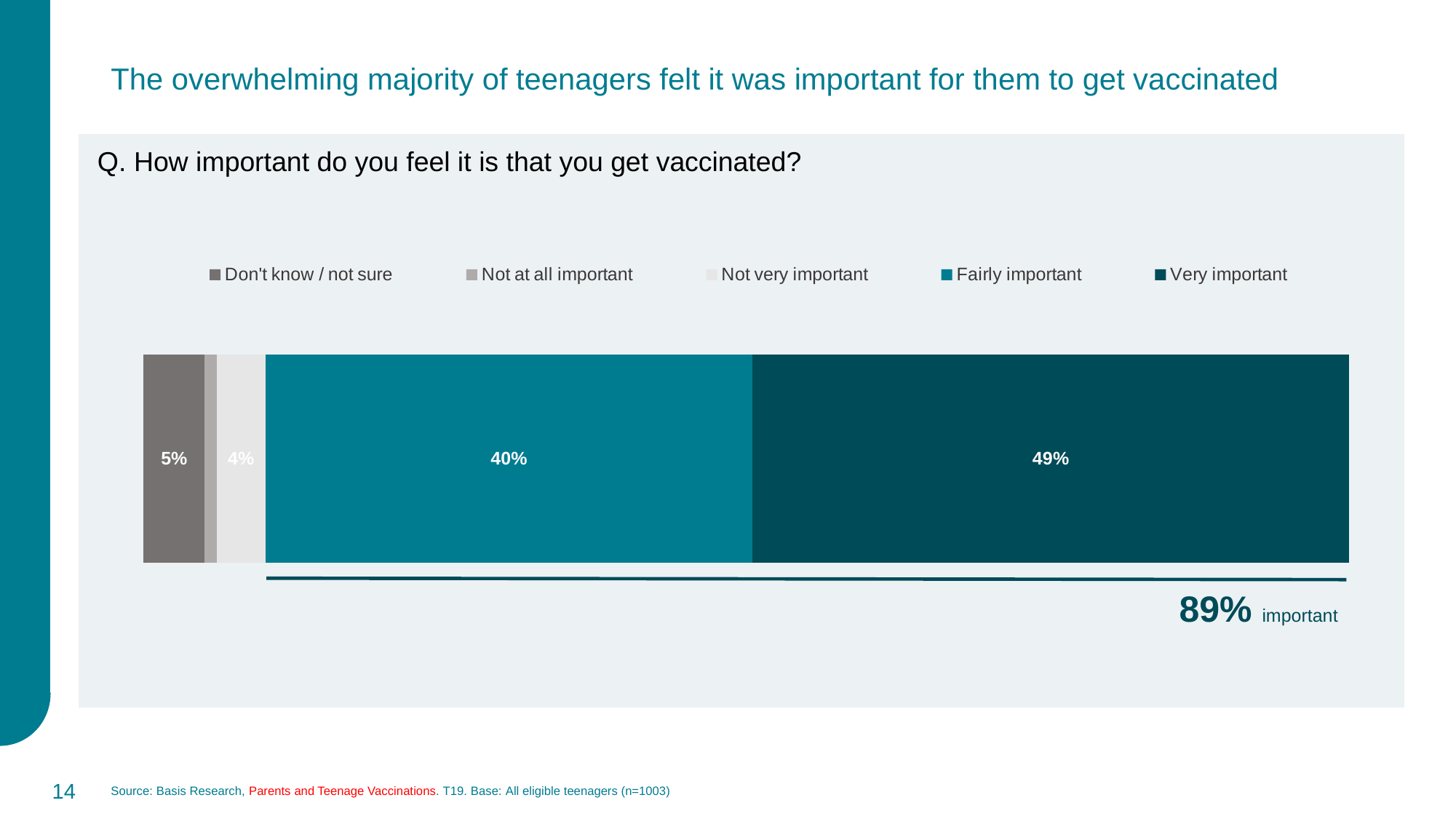
Which response category has the smallest share of teenagers? Not at all important What combined percentage of teenagers felt it was important (fairly or very) to get vaccinated? 89% What percentage of teenagers said it was 'Not very important'? 4% What type of chart is shown on the slide? Stacked bar chart What is the difference in percentage points between 'Very important' and 'Fairly important'? 9 What survey question is the chart based on? How important do you feel it is that you get vaccinated? How many response categories does the legend list? 5 Which is larger: the share for 'Don't know / not sure' or the share for 'Not very important'? Don't know / not sure What percentage of teenagers said it was 'Fairly important' that they get vaccinated? 40% Which response category has the largest share of teenagers? Very important What percentage of teenagers answered 'Don't know / not sure'? 5% What percentage of teenagers said it was 'Very important' that they get vaccinated? 49%